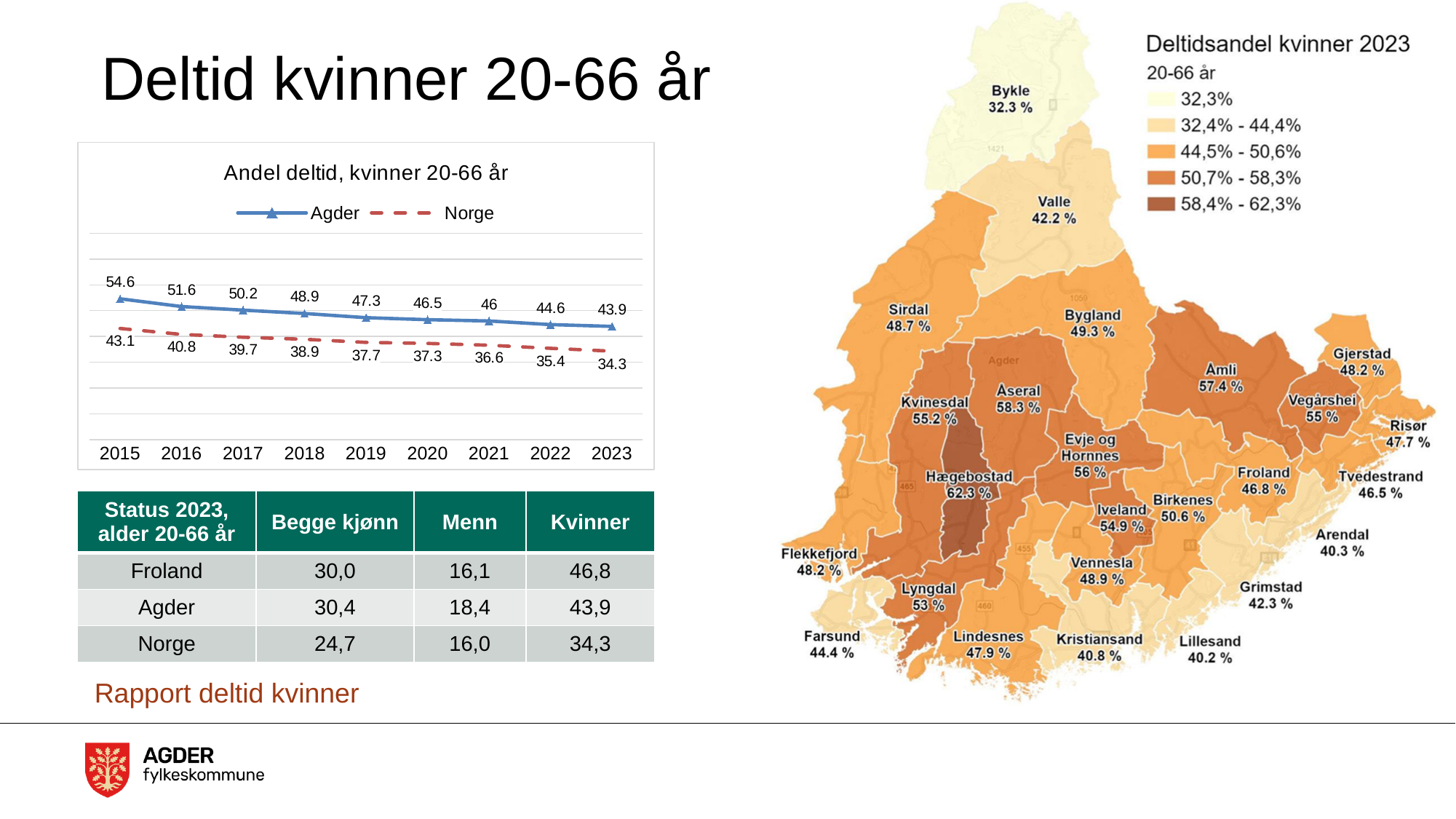
In the line chart 'Andel deltid, kvinner 20-66 år', by how much did the Agder value fall from 2015 to 2023? 10.7 In the line chart 'Andel deltid, kvinner 20-66 år', in which year is the Agder value highest? 2015 In the line chart 'Andel deltid, kvinner 20-66 år', do the Agder values rise or fall from 2015 to 2023? fall In the line chart 'Andel deltid, kvinner 20-66 år', in which year is the Norge value lowest? 2023 What kind of chart is 'Andel deltid, kvinner 20-66 år'? line chart In the line chart 'Andel deltid, kvinner 20-66 år', how many years are shown on the x axis? 9 In the line chart 'Andel deltid, kvinner 20-66 år', what is the value for Norge in 2023? 34.3 In the line chart 'Andel deltid, kvinner 20-66 år', how many series does the legend list? 2 In the line chart 'Andel deltid, kvinner 20-66 år', which series is drawn with a dashed red line? Norge In the line chart 'Andel deltid, kvinner 20-66 år', what is the difference between the Agder and Norge values in 2023? 9.6 In the line chart 'Andel deltid, kvinner 20-66 år', what is the value for Agder in 2015? 54.6 In the line chart 'Andel deltid, kvinner 20-66 år', which series has the higher value in 2019, Agder or Norge? Agder